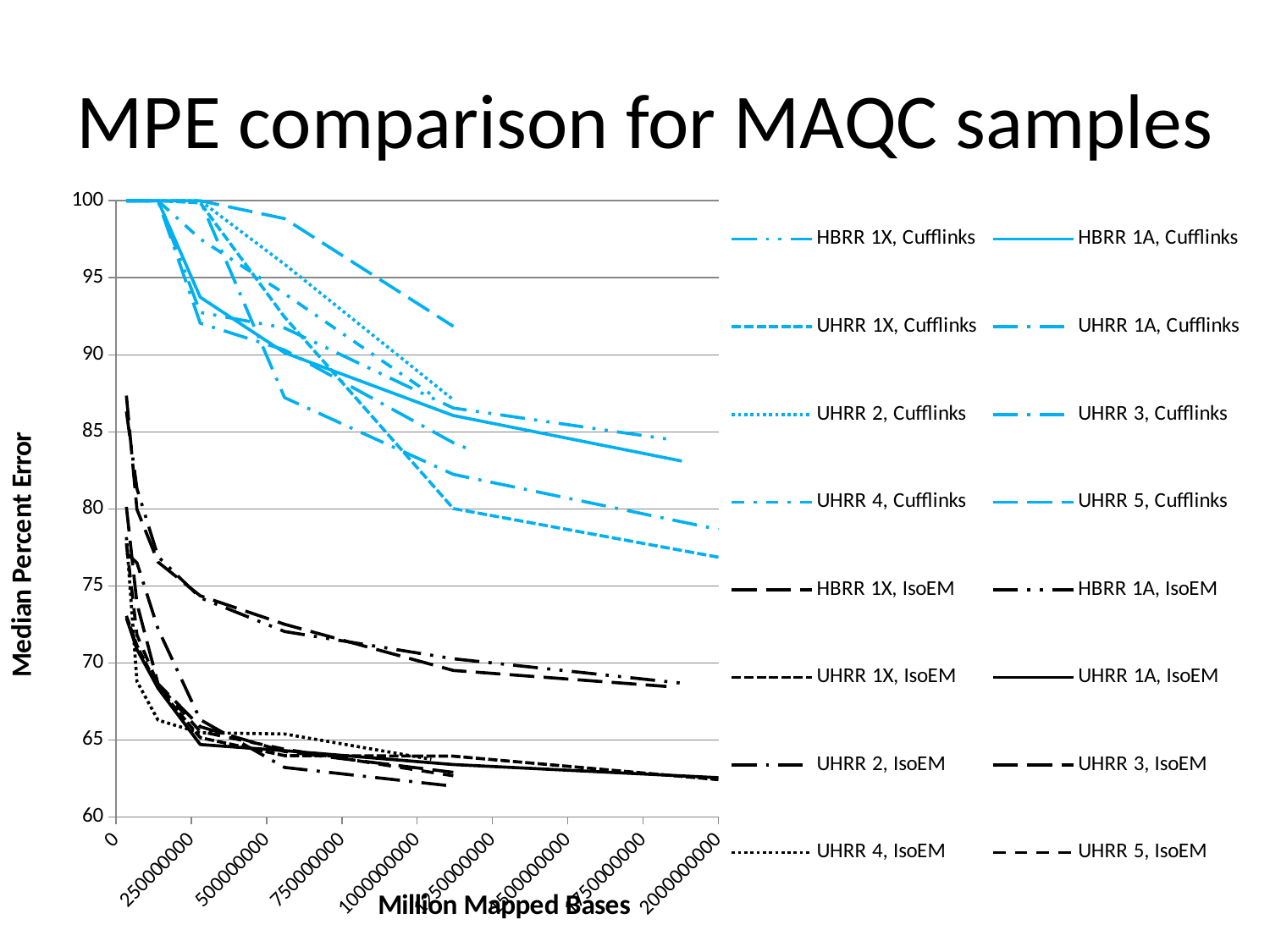
What kind of chart is shown on the slide? line chart Is the value for HBRR 1X, IsoEM at its last plotted point greater or less than 65? greater Do the Median Percent Error values rise or fall as Million Mapped Bases increases? fall How many series does the legend list? 16 Is the value for UHRR 1A, IsoEM at 2000000000 Million Mapped Bases greater or less than 65? less Which group of series has higher Median Percent Error values overall, the Cufflinks series or the IsoEM series? Cufflinks What is the label of the vertical axis? Median Percent Error Is the value for UHRR 1X, Cufflinks at 2000000000 Million Mapped Bases greater or less than 80? less What is the highest value shown on the vertical axis? 100 Which is larger at 2000000000 Million Mapped Bases, the value for HBRR 1A, Cufflinks or the value for UHRR 1A, IsoEM? HBRR 1A, Cufflinks What is the title of the chart? MPE comparison for MAQC samples